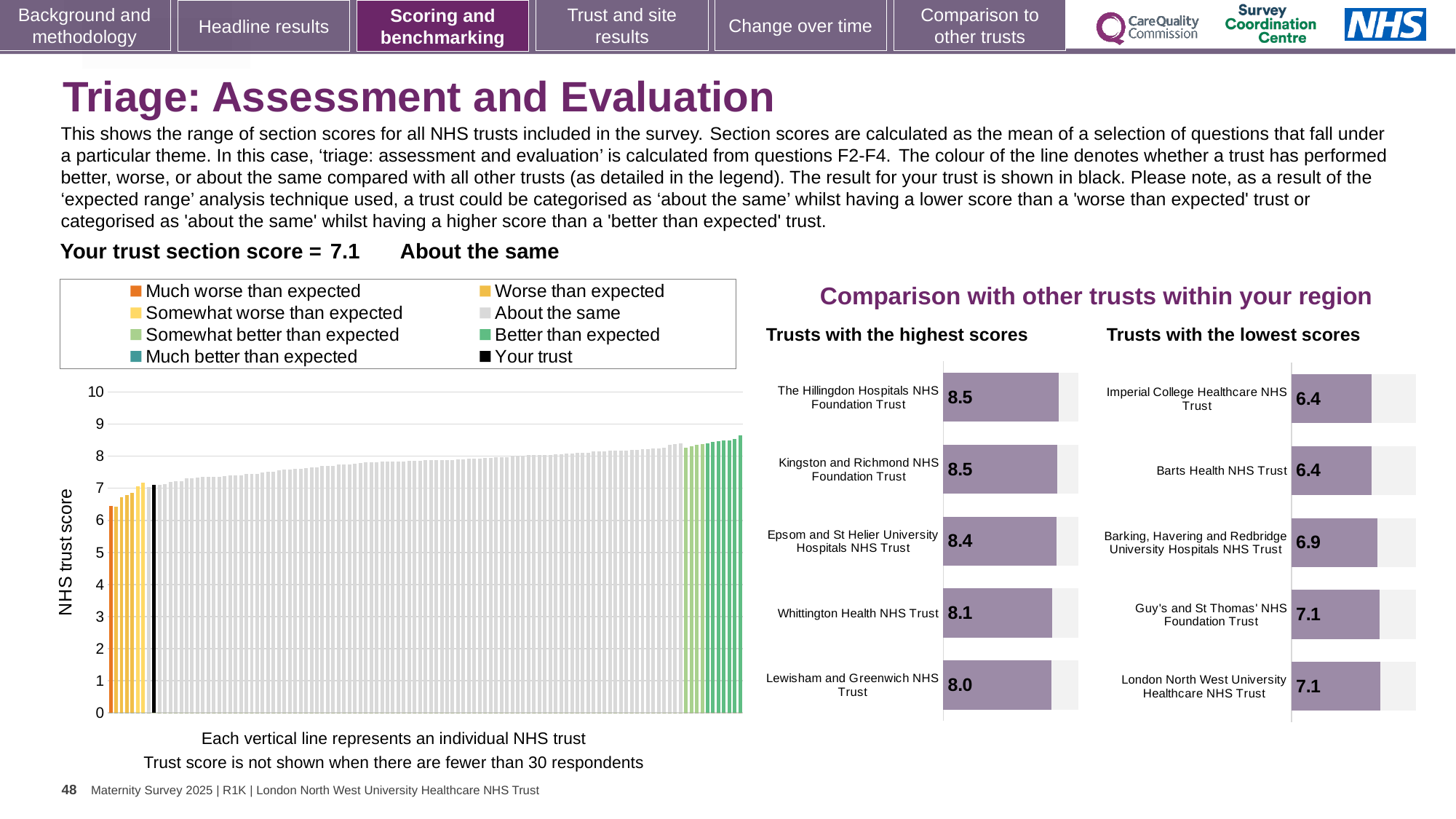
In the 'Trusts with the highest scores' chart, which trust has the lowest score shown? Lewisham and Greenwich NHS Trust What kind of chart is the NHS trust score chart on the left of the slide? Bar chart In the 'Trusts with the highest scores' chart, which has the higher score: Epsom and St Helier University Hospitals NHS Trust or Whittington Health NHS Trust? Epsom and St Helier University Hospitals NHS Trust In the legend of the NHS trust score chart, what colour represents 'Your trust'? Black In the 'Trusts with the lowest scores' chart, what is the score for Barking, Havering and Redbridge University Hospitals NHS Trust? 6.9 In the 'Trusts with the highest scores' chart, what is the score for Whittington Health NHS Trust? 8.1 In the NHS trust score chart on the left, what is the section score for your trust (the black bar)? 7.1 How many trusts are listed in the 'Trusts with the lowest scores' chart? 5 In the NHS trust score chart on the left, do the bars rise or fall from left to right? Rise In the 'Trusts with the highest scores' chart, how much higher is The Hillingdon Hospitals NHS Foundation Trust's score than Lewisham and Greenwich NHS Trust's score? 0.5 In the 'Trusts with the lowest scores' chart, what is the difference between the scores of Barking, Havering and Redbridge University Hospitals NHS Trust and Imperial College Healthcare NHS Trust? 0.5 How many entries does the legend of the NHS trust score chart on the left list? 8